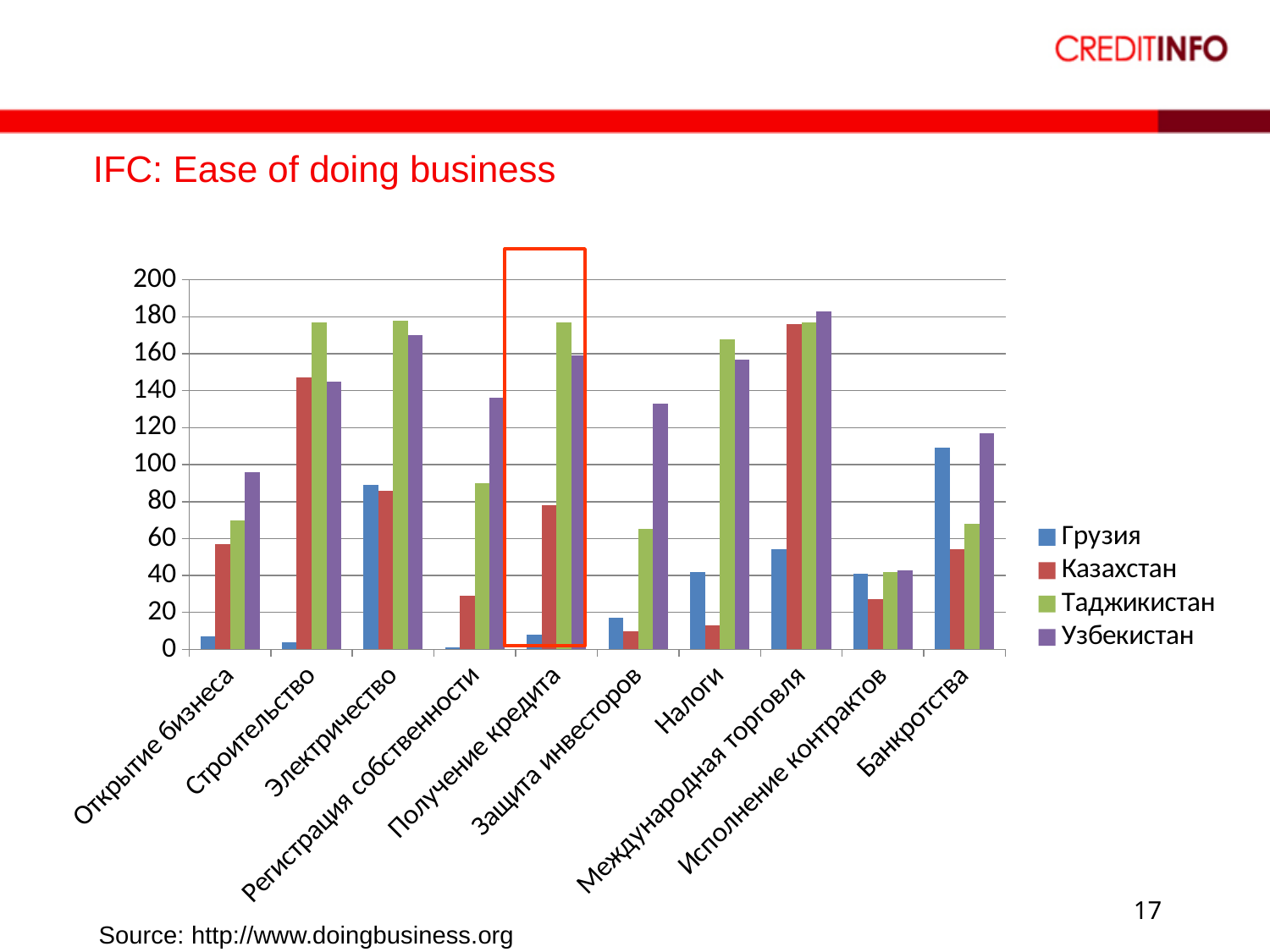
Is the value for Казахстан in Налоги greater or less than 20? less What is the title of the slide? IFC: Ease of doing business What kind of chart is shown on the slide? bar chart Is the value for Узбекистан in Регистрация собственности greater or less than 120? greater Which country has the highest value for Открытие бизнеса? Узбекистан How many categories are shown on the x axis? 10 Is the value for Грузия in Электричество greater or less than 80? greater How many series does the legend list? 4 Which category is highlighted with a red rectangle on the chart? Получение кредита Which country has the lowest value for Строительство? Грузия Which country has the highest value for Получение кредита? Таджикистан Which is larger for Банкротства: the value for Грузия or the value for Казахстан? Грузия